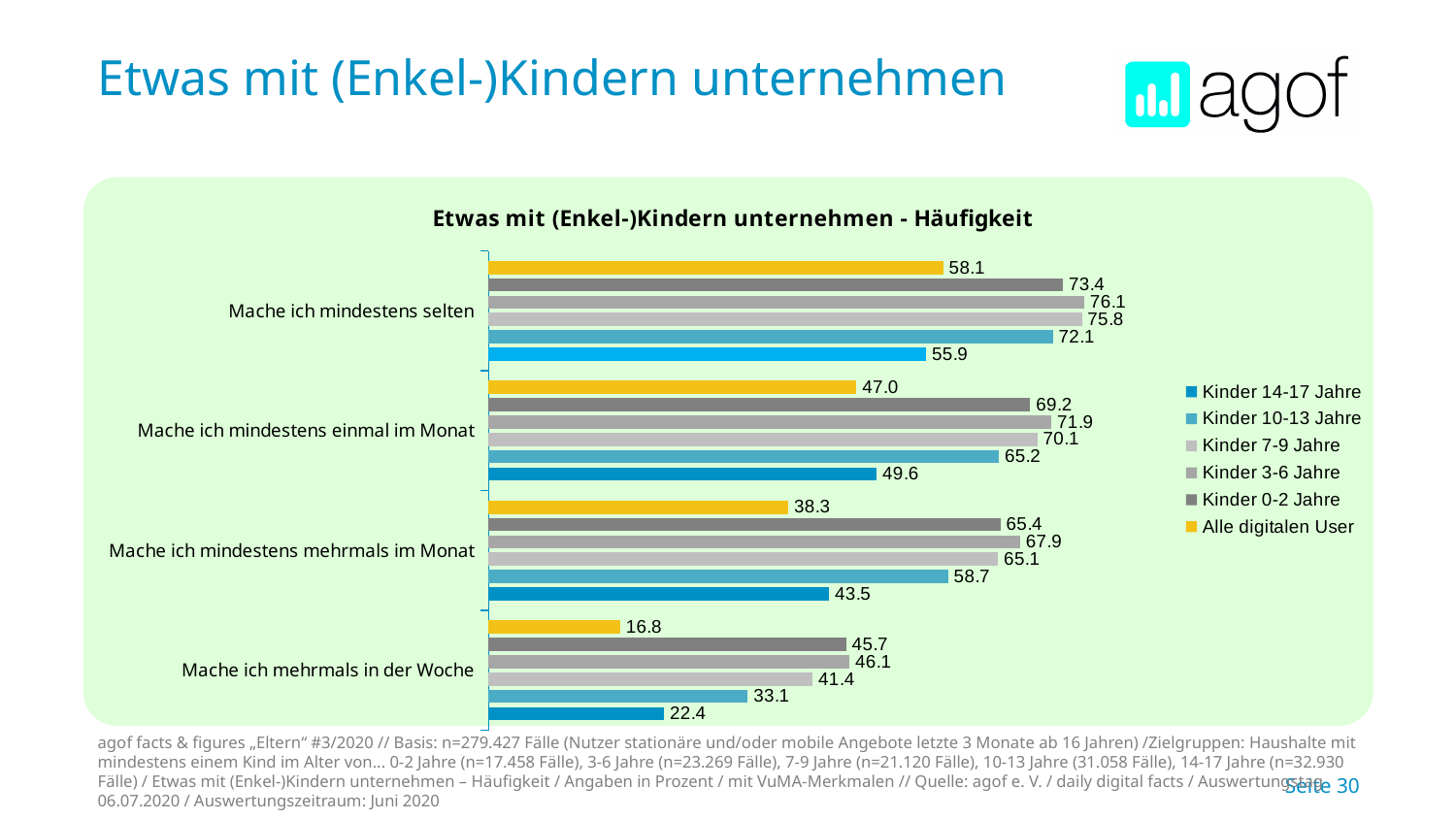
In the category 'Mache ich mindestens mehrmals im Monat', which is larger: the value for Kinder 0-2 Jahre or Kinder 7-9 Jahre? Kinder 0-2 Jahre What is the value for Kinder 3-6 Jahre in the category 'Mache ich mindestens einmal im Monat'? 71.9 What is the difference between the values for Kinder 0-2 Jahre and Alle digitalen User in the category 'Mache ich mehrmals in der Woche'? 28.9 How many categories are shown on the chart? 4 What is the value for Kinder 14-17 Jahre in the category 'Mache ich mehrmals in der Woche'? 22.4 What is the value for Alle digitalen User in the category 'Mache ich mindestens selten'? 58.1 What is the value for Kinder 10-13 Jahre in the category 'Mache ich mindestens mehrmals im Monat'? 58.7 Which series has the lowest value in the category 'Mache ich mindestens einmal im Monat'? Alle digitalen User What kind of chart is shown on the slide? Bar chart How many series does the legend list? 6 Which series has the highest value in the category 'Mache ich mehrmals in der Woche'? Kinder 3-6 Jahre What is the title of the chart? Etwas mit (Enkel-)Kindern unternehmen - Häufigkeit